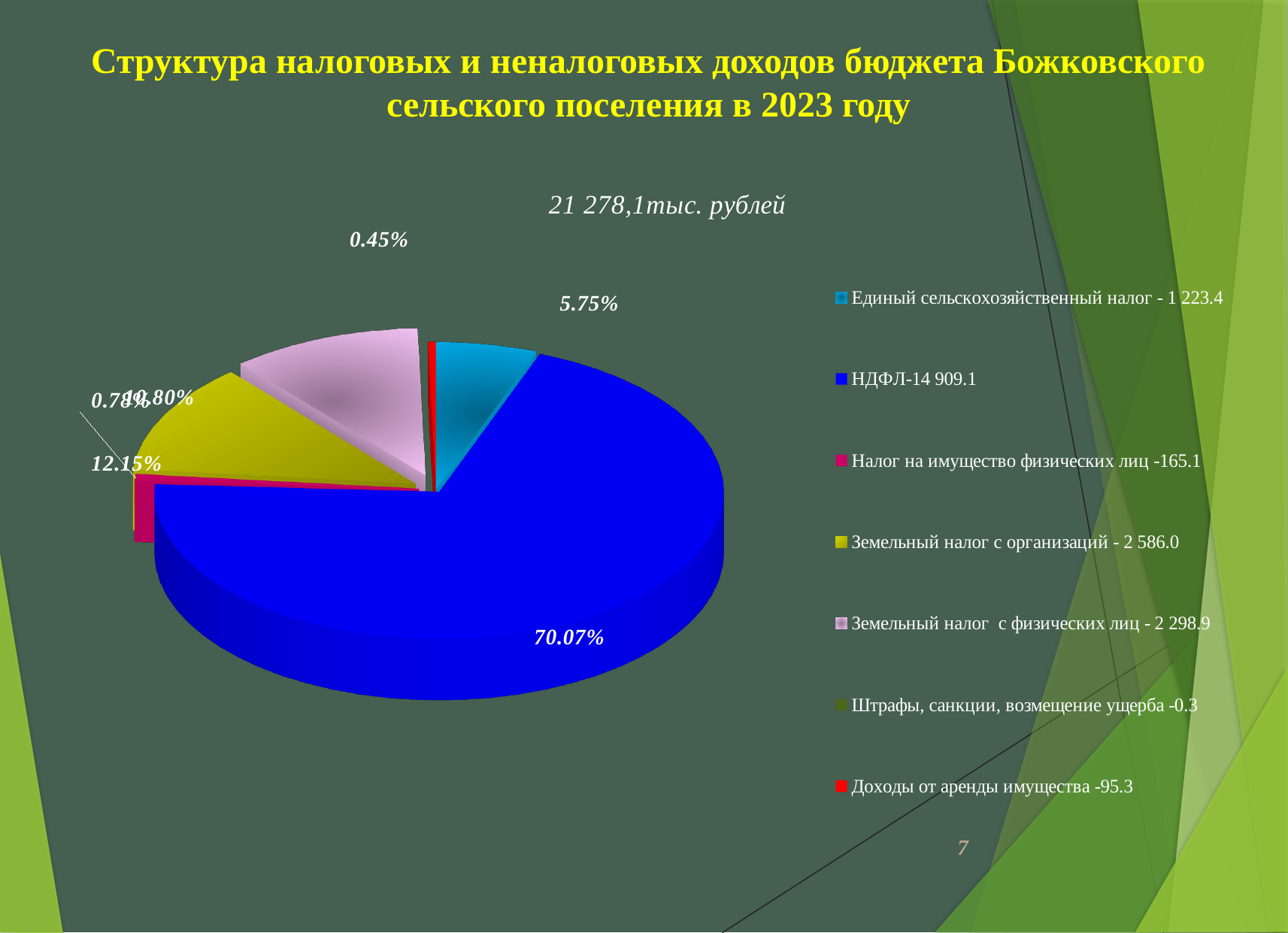
Which slice is larger: Земельный налог с организаций or Земельный налог с физических лиц? Земельный налог с организаций Which category has the largest slice of the pie? НДФЛ What percentage is shown for Единый сельскохозяйственный налог? 5.75% What value is given for НДФЛ in the legend? 14 909.1 What total amount is printed above the pie chart? 21 278,1тыс. рублей What is the difference in percentage points between the НДФЛ slice and the Земельный налог с организаций slice? 57.92% What share of the pie does НДФЛ account for? 70.07% What percentage is shown for Доходы от аренды имущества? 0.45% How many categories does the legend list? 7 What type of chart is shown on the slide? Pie chart